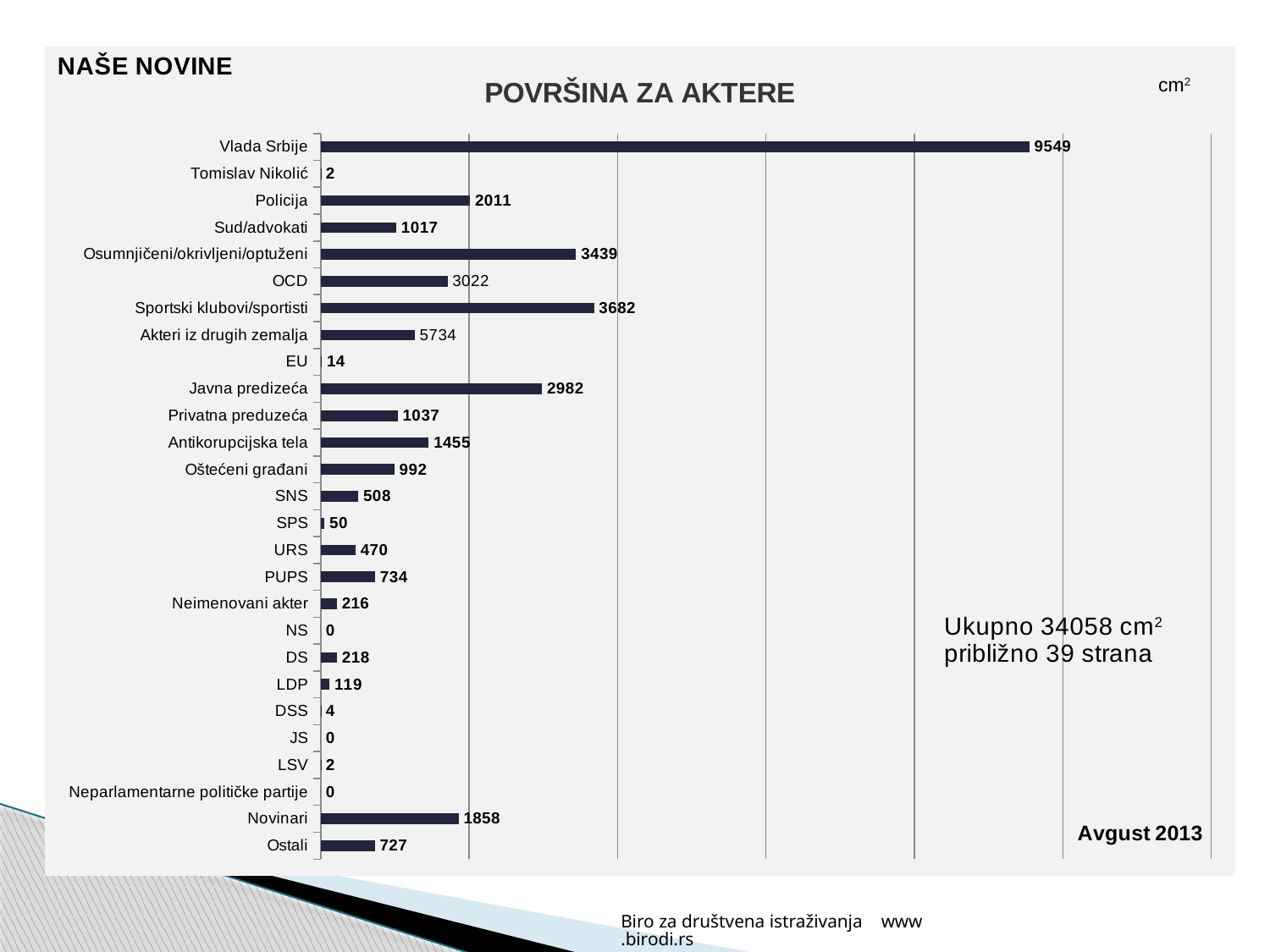
What type of chart is shown on the slide? bar chart How many categories are shown in the chart? 27 What is the title of the chart? POVRŠINA ZA AKTERE What is the value for Novinari? 1858 Which is larger, the value for SNS or the value for URS? SNS What is the value for Vlada Srbije? 9549 What is the value for Antikorupcijska tela? 1455 What is the difference between the values for Policija and Sud/advokati? 994 Which is larger, the value for Javna predizeća or the value for Policija? Javna predizeća Which category has the highest value? Vlada Srbije What is the value for Policija? 2011 What is the difference between the values for Novinari and Ostali? 1131